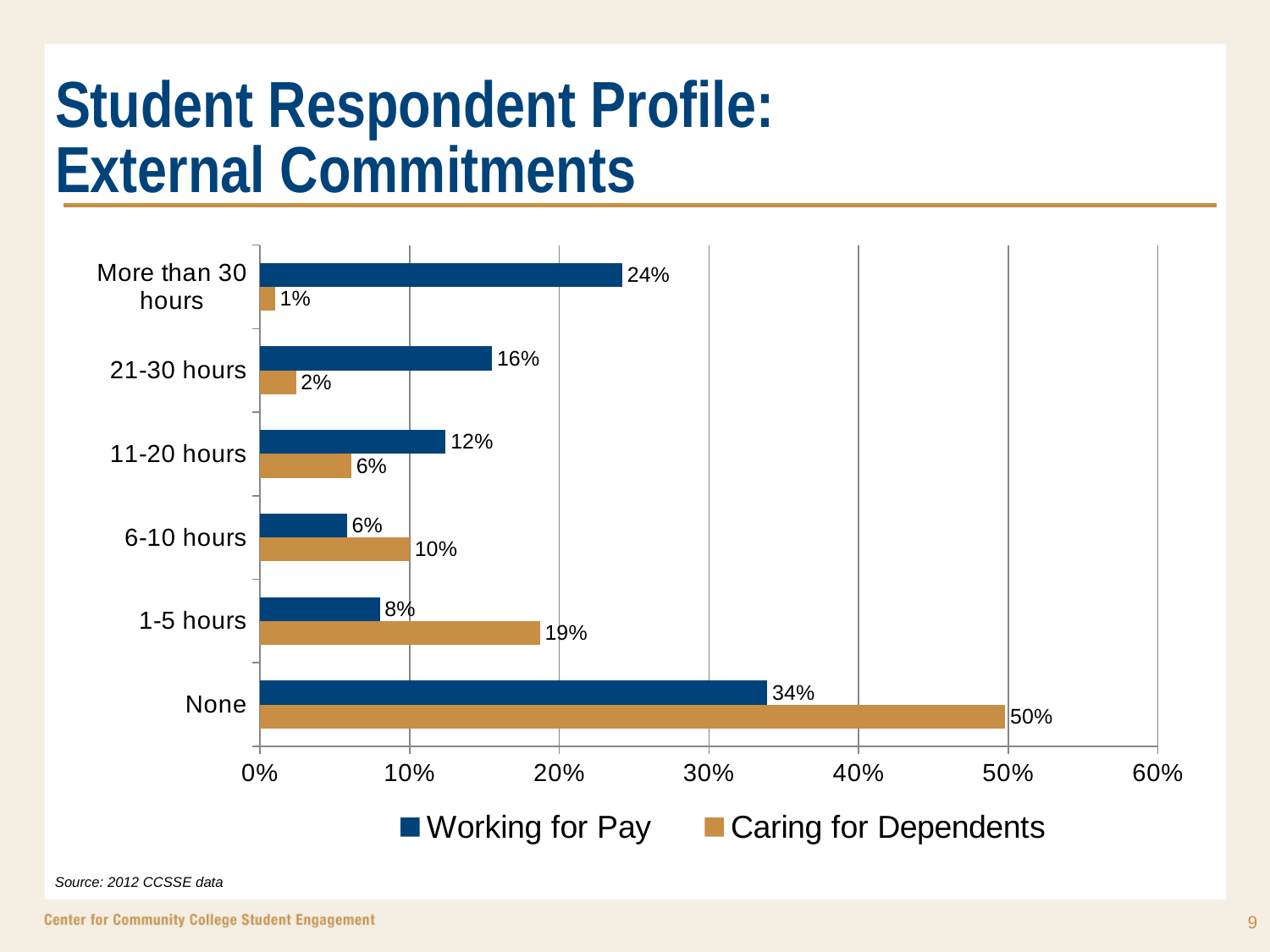
Which category has the lowest value for Caring for Dependents? More than 30 hours How many hour categories are shown on the chart? 6 What is the value for Caring for Dependents in the None category? 50% What percentage of students report working for pay more than 30 hours? 24% How many series does the legend list? 2 For 21-30 hours, which is larger: Working for Pay or Caring for Dependents? Working for Pay What kind of chart is shown on the slide? Bar chart What is the source of the data cited on the slide? 2012 CCSSE data What percentage of students report caring for dependents 1-5 hours? 19% What is the difference between Caring for Dependents and Working for Pay in the None category? 16% Which category has the highest value for Working for Pay? None Is the Working for Pay value for None greater or less than 30%? greater